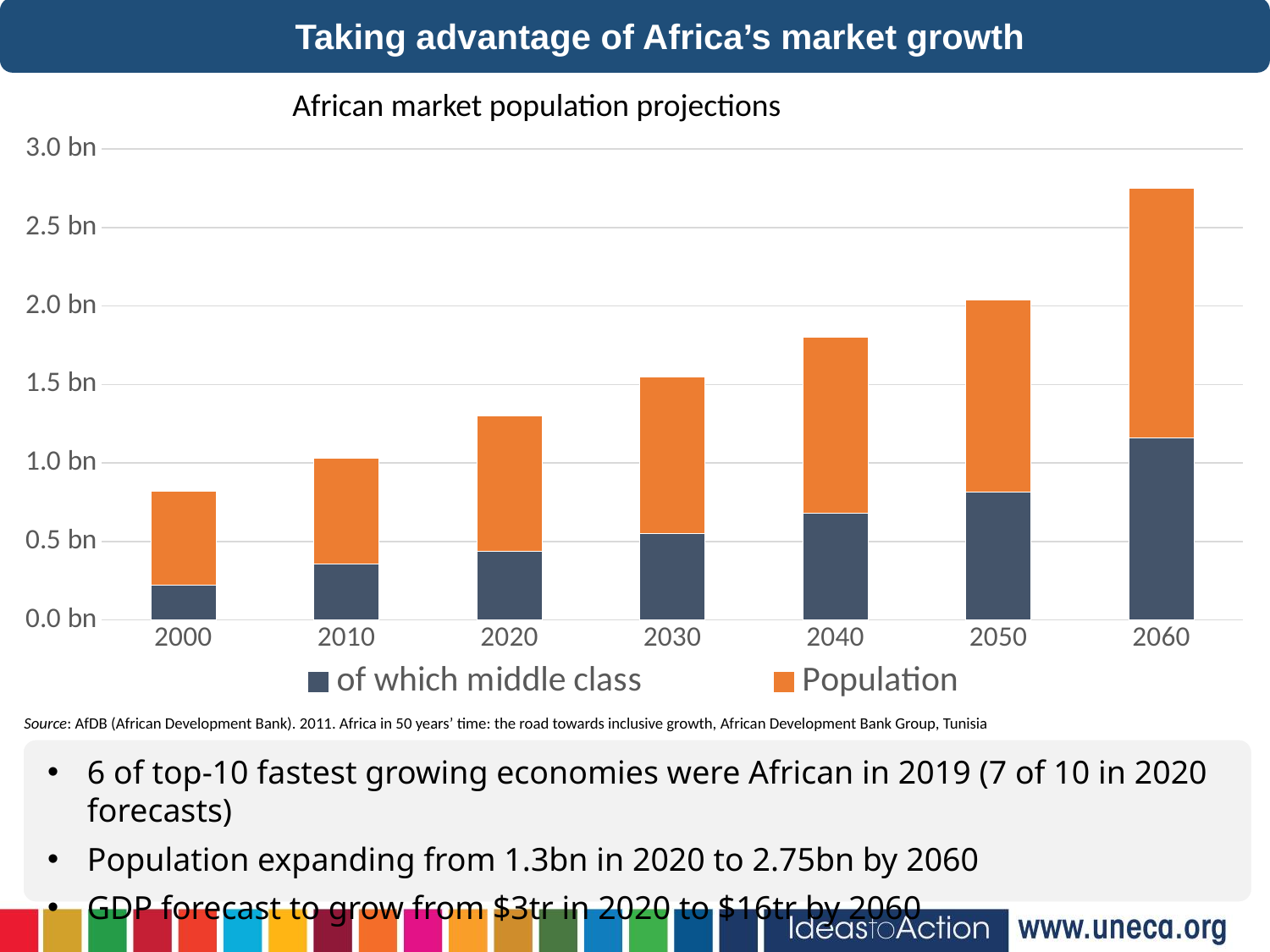
Is the 'of which middle class' value for 2060 greater or less than 1.0 bn? greater Is the total stacked bar for 2060 greater or less than 2.5 bn? greater What kind of chart is shown on the slide? bar chart Which year has the shortest stacked bar? 2000 Is the 'of which middle class' value for 2000 greater or less than 0.5 bn? less Do the stacked bar totals rise or fall from 2000 to 2060? rise Which year has the larger total stacked bar, 2030 or 2040? 2040 How many series does the legend list? 2 Which year has the tallest stacked bar? 2060 How many years are shown on the x axis of the chart? 7 What is the title of the chart? African market population projections